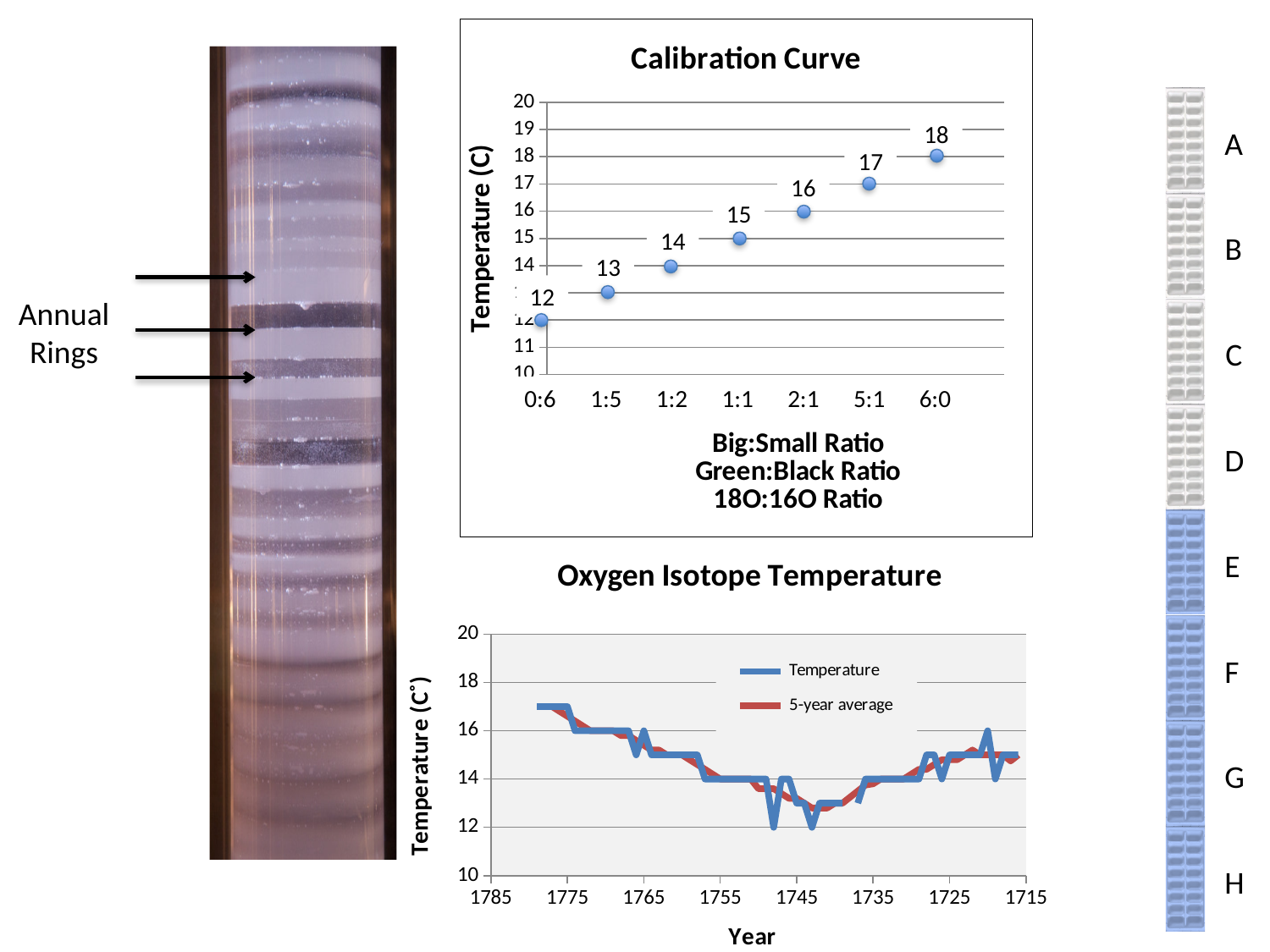
In the Oxygen Isotope Temperature chart, which colour is used for the 5-year average series? red How many series does the legend of the Oxygen Isotope Temperature chart list? 2 In the Calibration Curve chart, what is the temperature for the ratio 0:6? 12 In the Calibration Curve chart, how many data points are plotted? 7 In the Calibration Curve chart, what is the temperature for the ratio 1:1? 15 In the Calibration Curve chart, which ratio has the lowest temperature? 0:6 In the Calibration Curve chart, which ratio has the highest temperature? 6:0 In the Calibration Curve chart, what is the difference in temperature between the ratios 5:1 and 1:5? 4 In the Calibration Curve chart, what is the temperature for the ratio 6:0? 18 What kind of chart is the Oxygen Isotope Temperature chart? line chart In the Calibration Curve chart, do the temperatures rise or fall as the ratio moves from 0:6 to 6:0? rise In the Oxygen Isotope Temperature chart, is the Temperature value at 1775 greater or less than 16? greater